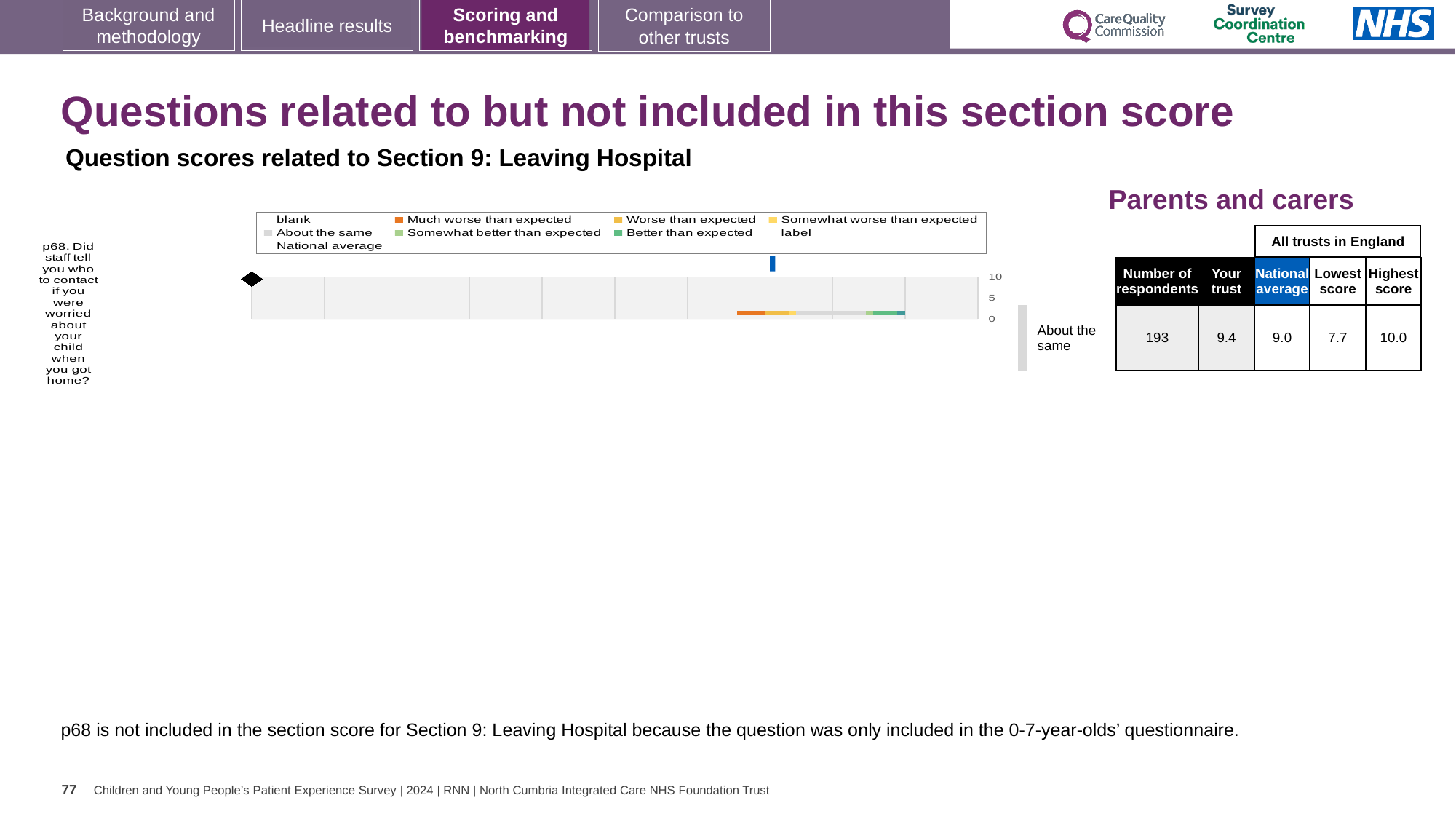
According to the table next to the chart, what is the 'Your trust' score for p68? 9.4 How many questions (categories) are plotted in the chart? 1 According to the table next to the chart, what is the highest score among all trusts in England for p68? 10.0 Which question is plotted in the chart? p68. Did staff tell you who to contact if you were worried about your child when you got home? What is the difference between the 'Your trust' score and the national average for p68? 0.4 What benchmark category is the trust's p68 score placed in, as labelled beside the chart? About the same According to the table next to the chart, what is the lowest score among all trusts in England for p68? 7.7 What kind of chart is shown on the slide for question p68? bar chart How many respondents answered p68 according to the table next to the chart? 193 What is the highest tick value shown on the chart's axis? 10 According to the table next to the chart, what is the national average score for p68? 9.0 Is the 'Your trust' score for p68 larger or smaller than the national average? larger